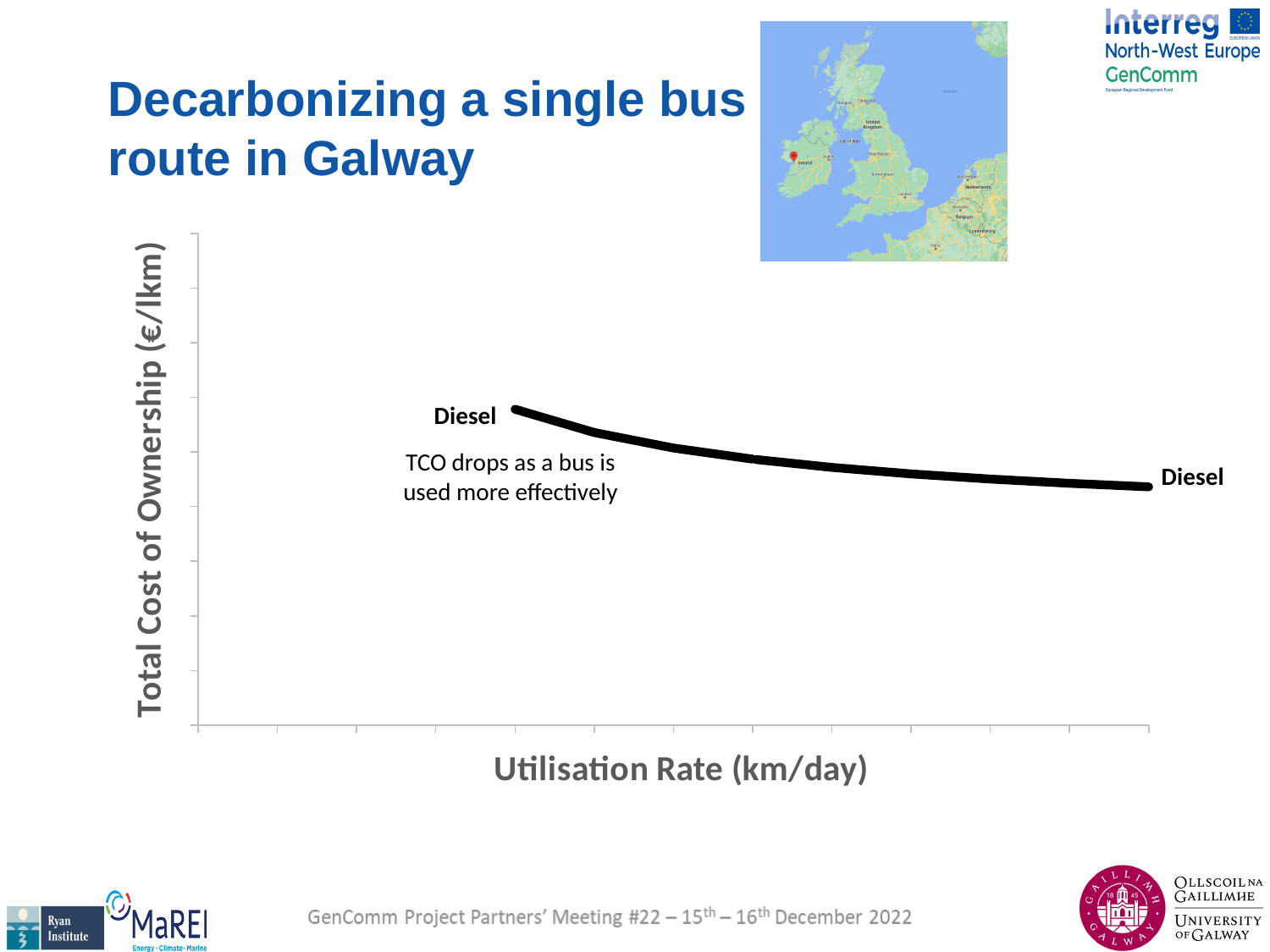
What kind of chart is shown on the slide? line chart What is the title of the y axis of the chart? Total Cost of Ownership (€/lkm) Does the Diesel line rise or fall as the utilisation rate increases along the x axis? fall What is the title of the x axis of the chart? Utilisation Rate (km/day) How many data series are plotted on the chart? 1